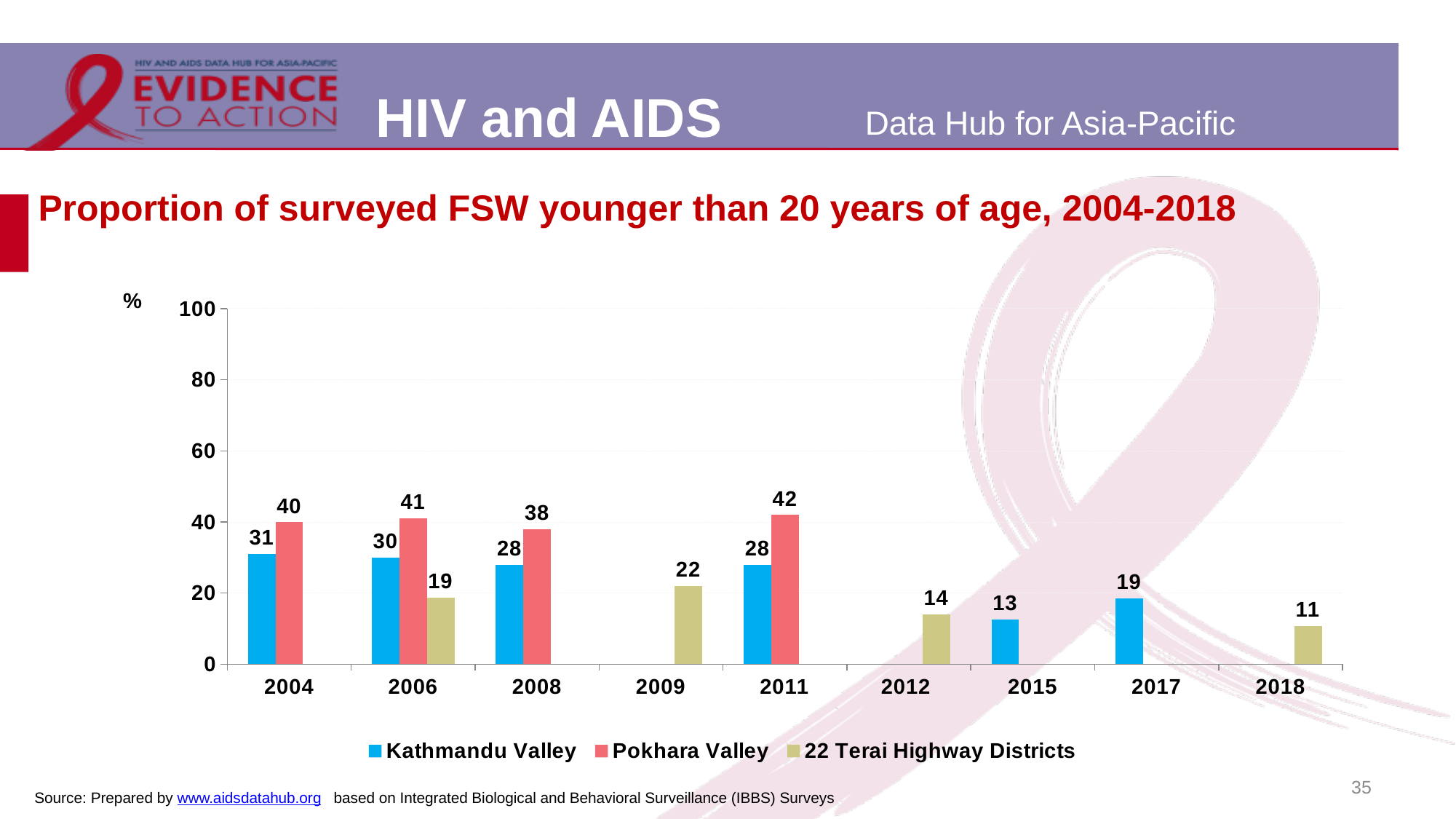
What is the value for Kathmandu Valley in 2017? 19 What is the value for Pokhara Valley in 2011? 42 What is the value for 22 Terai Highway Districts in 2009? 22 In which year is the Kathmandu Valley value lowest? 2015 How many series does the legend list? 3 How many years are shown on the x axis? 9 What is the value for Kathmandu Valley in 2004? 31 Which is larger in 2008, Kathmandu Valley or Pokhara Valley? Pokhara Valley What kind of chart is this? Bar chart What is the difference between the Pokhara Valley and Kathmandu Valley values in 2006? 11 Does the Kathmandu Valley value rise or fall from 2004 to 2015? Fall In which year is the Pokhara Valley value highest? 2011